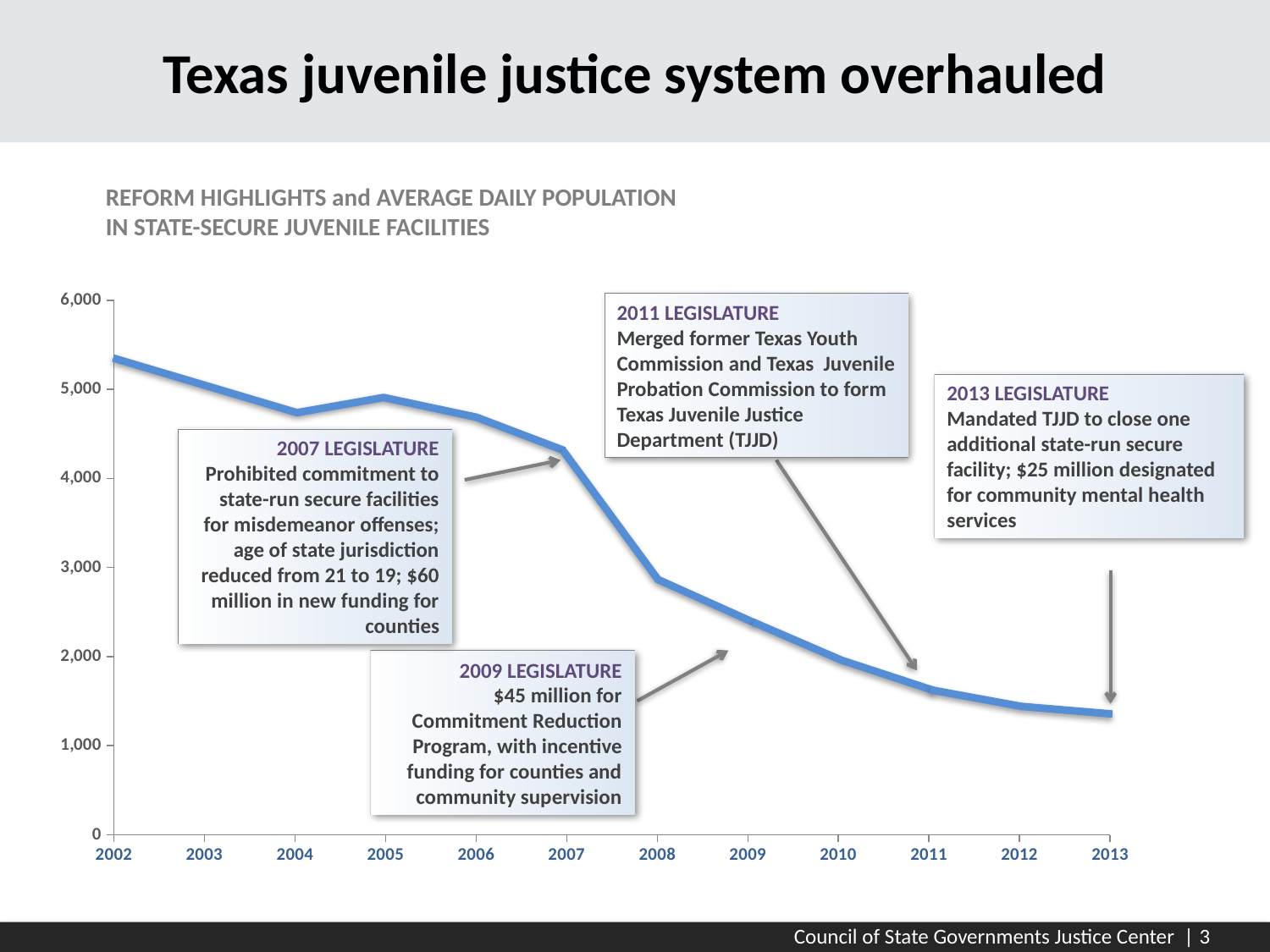
Is the value for 2007 greater or less than 4,000? greater Is the value for 2008 greater or less than 3,000? less Is the value for 2013 greater or less than 2,000? less Which year has the highest average daily population on the chart? 2002 What is the title of the chart? REFORM HIGHLIGHTS and AVERAGE DAILY POPULATION IN STATE-SECURE JUVENILE FACILITIES How many legislature callout boxes are annotated on the chart? 4 Which year has the larger value, 2007 or 2008? 2007 Does the average daily population generally rise or fall from 2002 to 2013? fall What kind of chart is shown on the slide? line chart How many years are plotted along the x axis of the chart? 12 Which year has the lowest average daily population on the chart? 2013